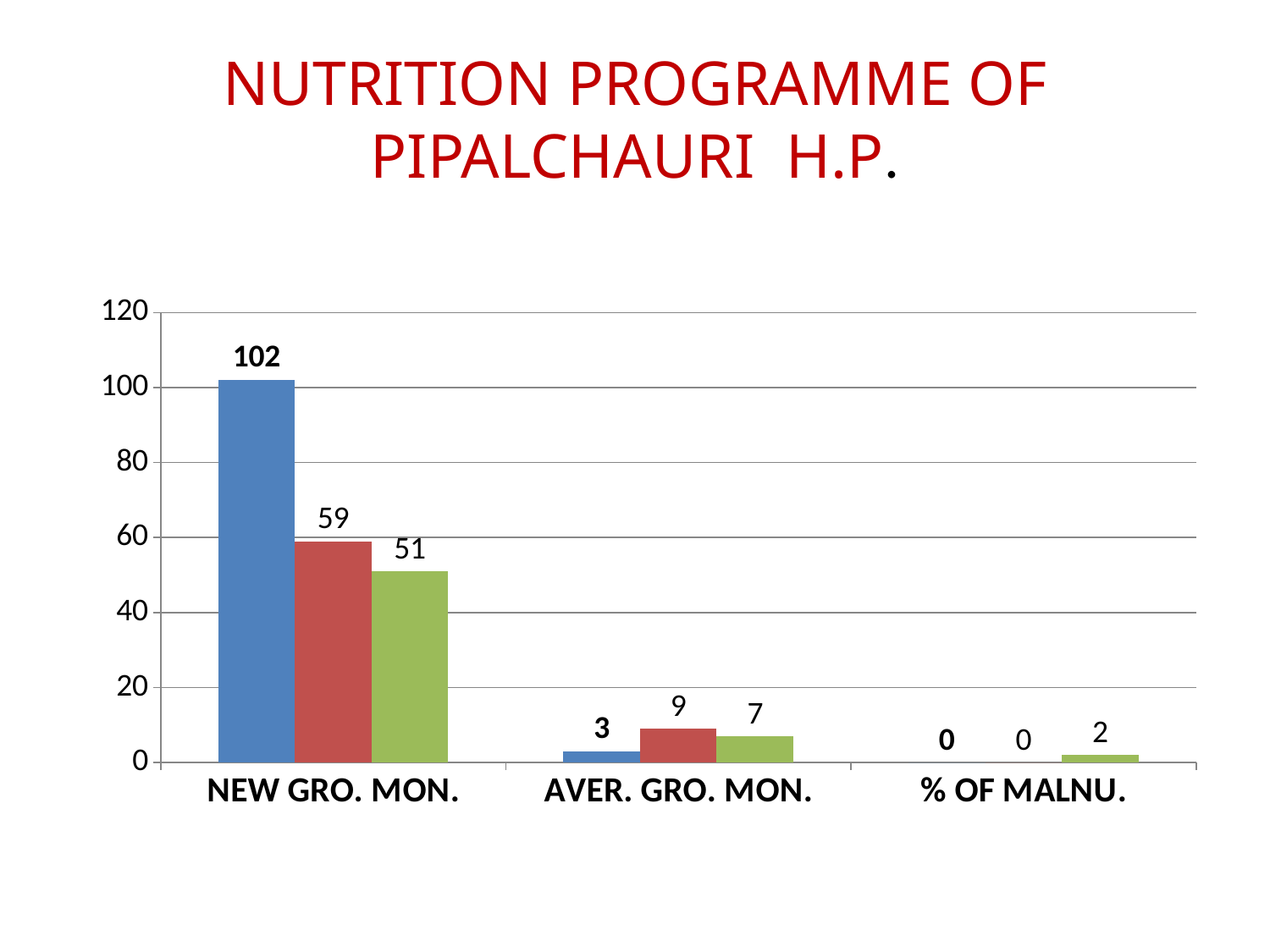
What is the difference between the blue and red bars for NEW GRO. MON.? 43 How many categories are shown on the x axis? 3 Which category has the lowest red bar? % OF MALNU. What is the value of the red bar for AVER. GRO. MON.? 9 What is the value of the green bar for NEW GRO. MON.? 51 What kind of chart is shown on the slide? bar chart What is the value of the blue bar for NEW GRO. MON.? 102 Which is larger for AVER. GRO. MON., the blue bar or the red bar? the red bar Is the value of the blue bar for NEW GRO. MON. greater or less than 100? greater Which category has the highest blue bar? NEW GRO. MON. What is the value of the green bar for % OF MALNU.? 2 What is the title of the slide? NUTRITION PROGRAMME OF PIPALCHAURI H.P.